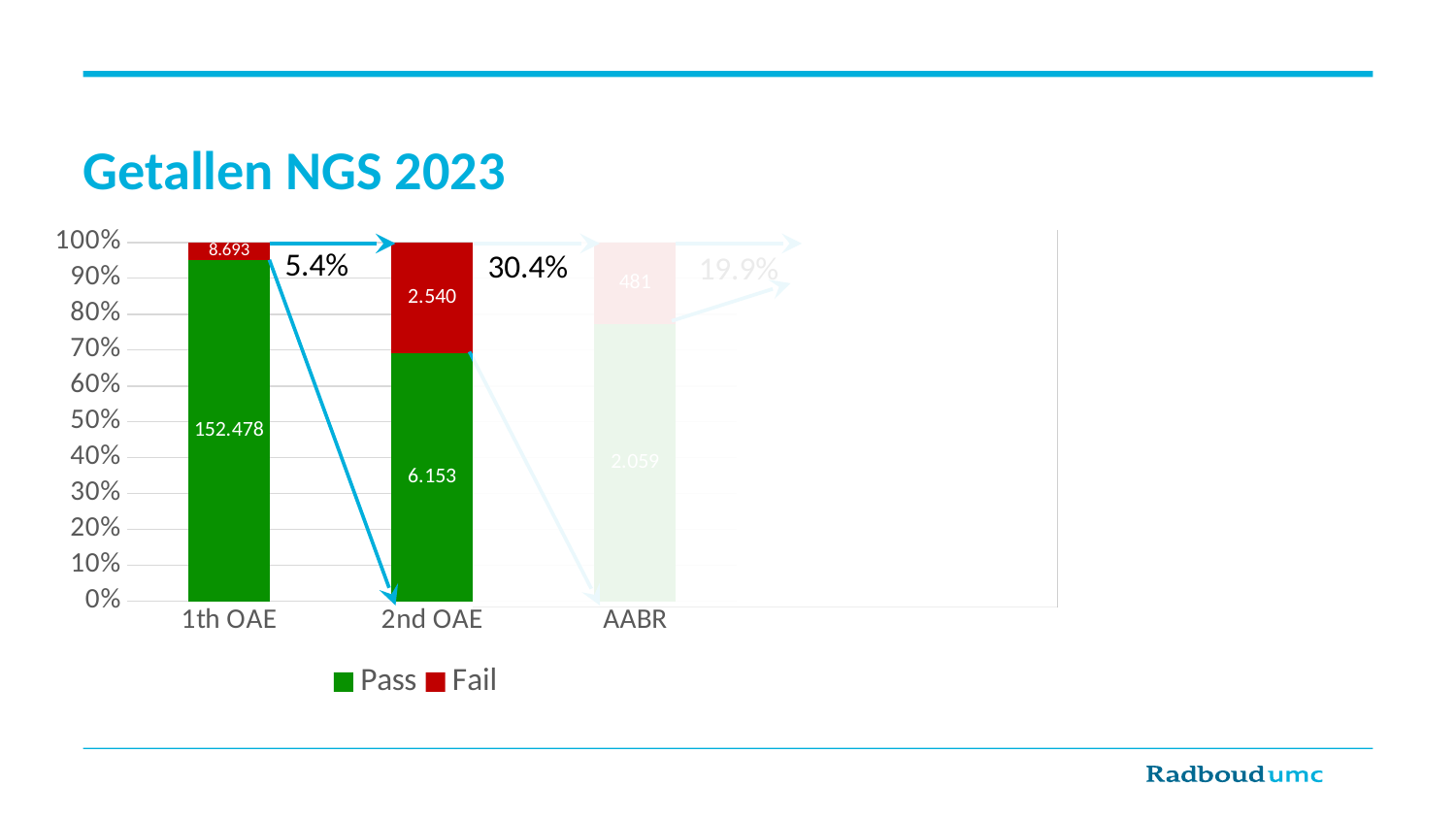
What is the title of the chart? Getallen NGS 2023 How many series does the legend list? 2 Is the Pass share of the 2nd OAE bar greater or less than 60%? greater What percentage is annotated next to the 2nd OAE bar? 30.4% What is the total of the 2nd OAE stacked bar (Pass plus Fail)? 8.693 What is the Pass value for 2nd OAE? 6.153 What is the Fail value for 1th OAE? 8.693 What is the difference between the Pass and Fail values for 2nd OAE? 3.613 What is the Pass value for 1th OAE? 152.478 Which is larger for 1th OAE, the Pass value or the Fail value? Pass What is the Fail value for 2nd OAE? 2.540 What percentage is annotated between the 1th OAE and 2nd OAE bars? 5.4%